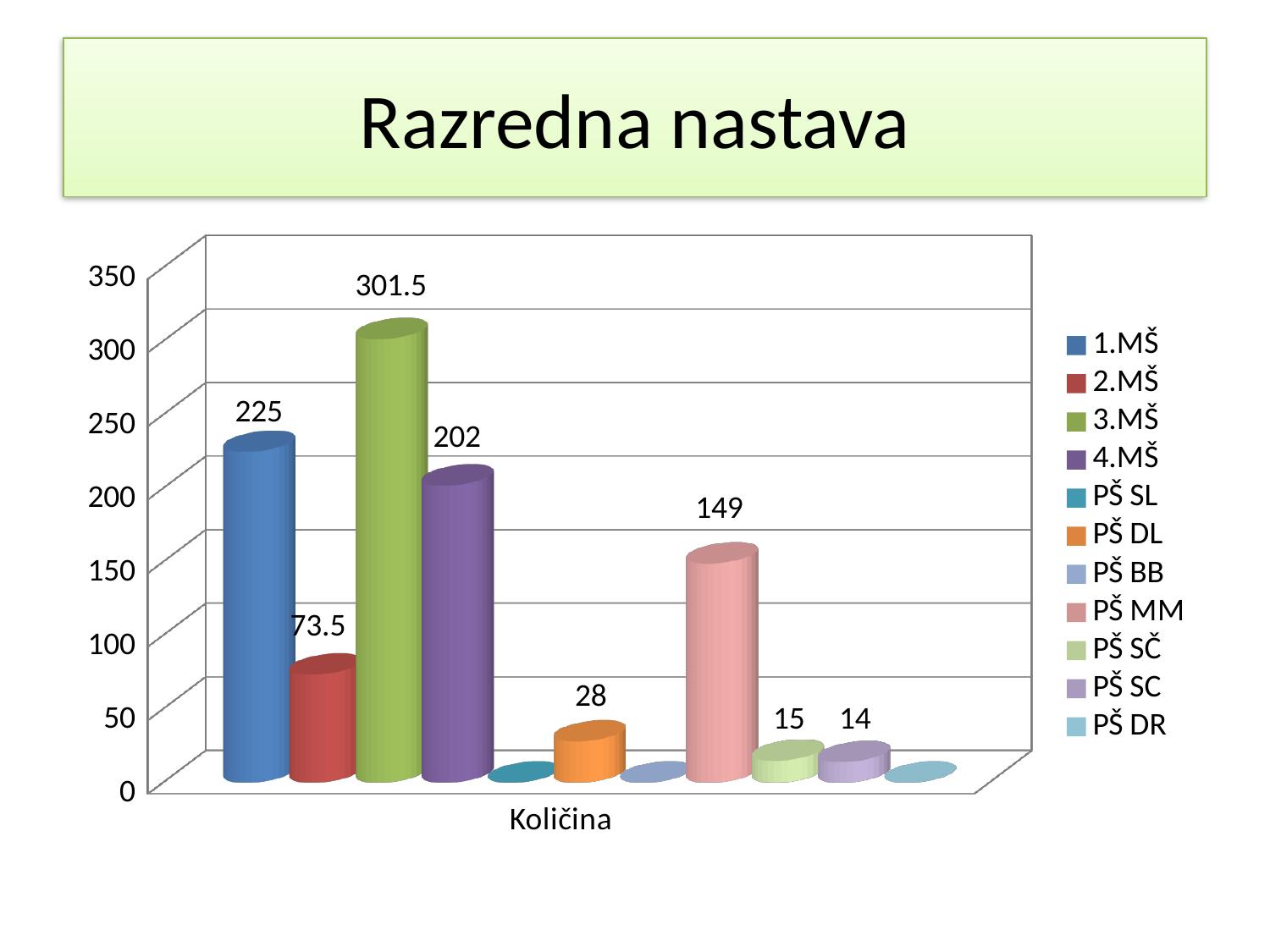
What kind of chart is shown on the slide? Bar chart What is the category label shown on the x axis? Količina Which is larger, the value for 1.MŠ or the value for 4.MŠ? 1.MŠ What is the value for 2.MŠ? 73.5 How many series does the legend list? 11 Which series has the highest value? 3.MŠ What is the value for PŠ DL? 28 What is the value for 3.MŠ? 301.5 What is the value for PŠ MM? 149 Which is larger, the value for PŠ SČ or the value for PŠ SC? PŠ SČ What is the difference between the values for 3.MŠ and 1.MŠ? 76.5 What is the difference between the values for 1.MŠ and 4.MŠ? 23